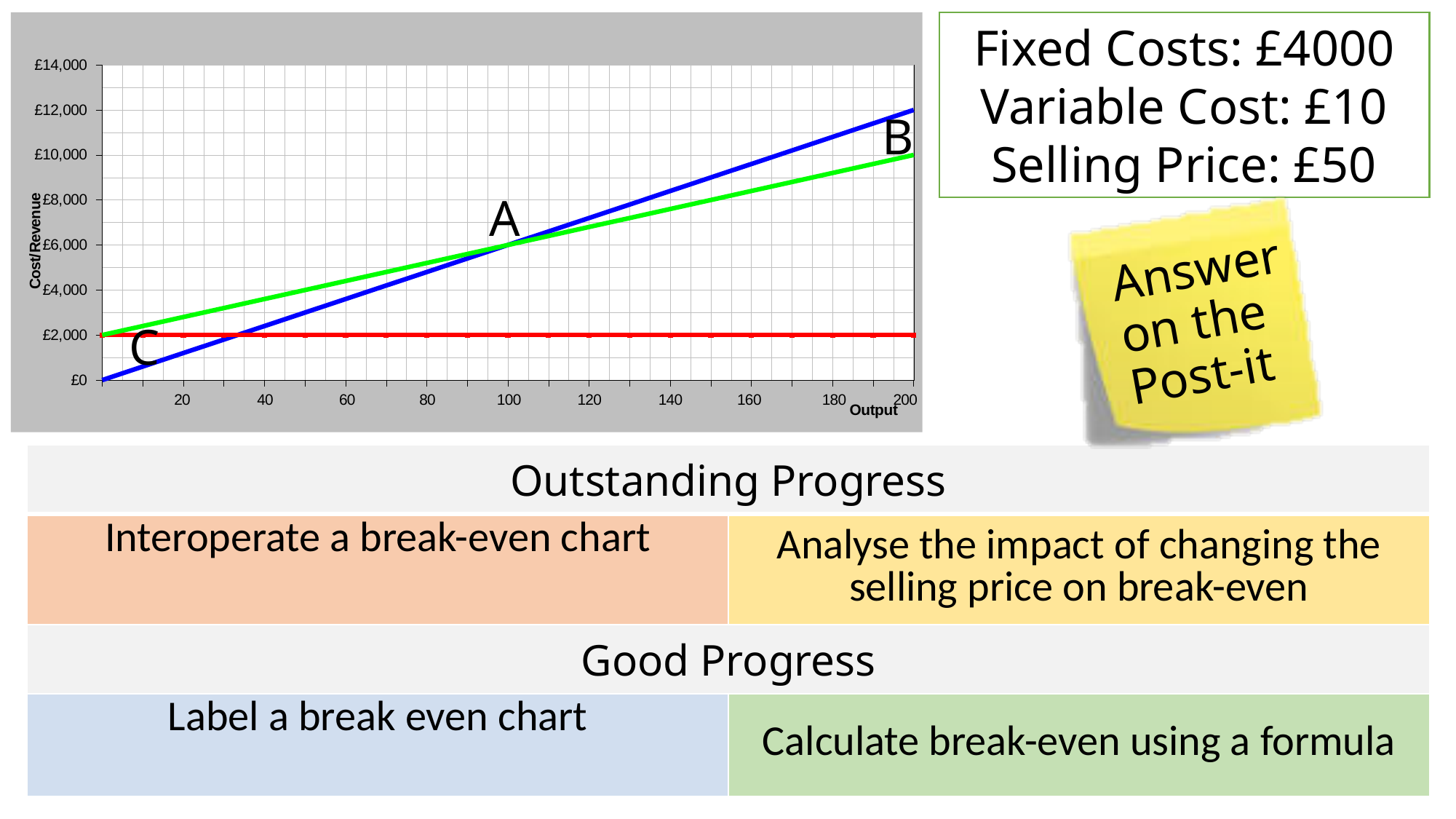
What is the difference between the blue line and the green line at an output of 200? £2,000 What type of chart is shown on the slide? Line chart Does the blue line rise or fall as output increases? Rises At an output of 200, which line is higher, the blue line or the green line? Blue line How many lines are plotted on the chart? 3 What is the label on the horizontal axis of the chart? Output What is the label on the vertical axis of the chart? Cost/Revenue At what output level do the blue and green lines cross at point A? 100 At what value does the horizontal red line sit on the chart? £2,000 What value does the green line reach at an output of 200? £10,000 Is the value of the blue line at an output of 160 greater or less than £8,000? greater What value does the blue line reach at an output of 200? £12,000